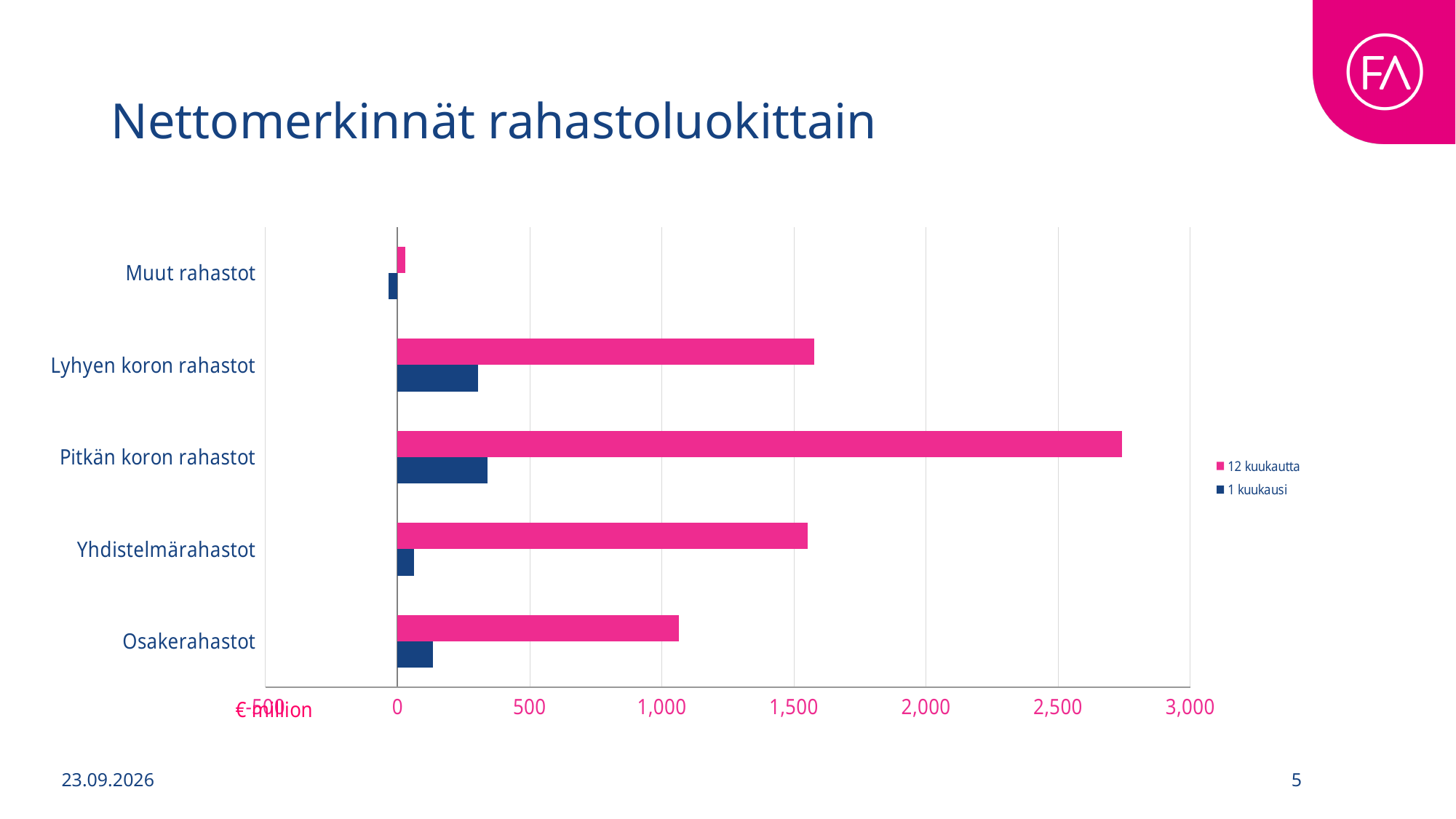
What is the title of the chart slide? Nettomerkinnät rahastoluokittain Which category has the highest value for the 12 kuukautta series? Pitkän koron rahastot Is the 12 kuukautta value for Osakerahastot greater or less than 1,000? greater Which category has the lowest value for the 12 kuukautta series? Muut rahastot Which category has the lowest value for the 1 kuukausi series? Muut rahastot Which is larger for the 12 kuukautta series: Osakerahastot or Yhdistelmärahastot? Yhdistelmärahastot What kind of chart is shown on the slide? bar chart How many series does the legend list? 2 Which is larger for the 1 kuukausi series: Osakerahastot or Yhdistelmärahastot? Osakerahastot Is the 12 kuukautta value for Pitkän koron rahastot greater or less than 2,500? greater Is the 1 kuukausi value for Lyhyen koron rahastot greater or less than 500? less How many fund categories are shown on the chart? 5